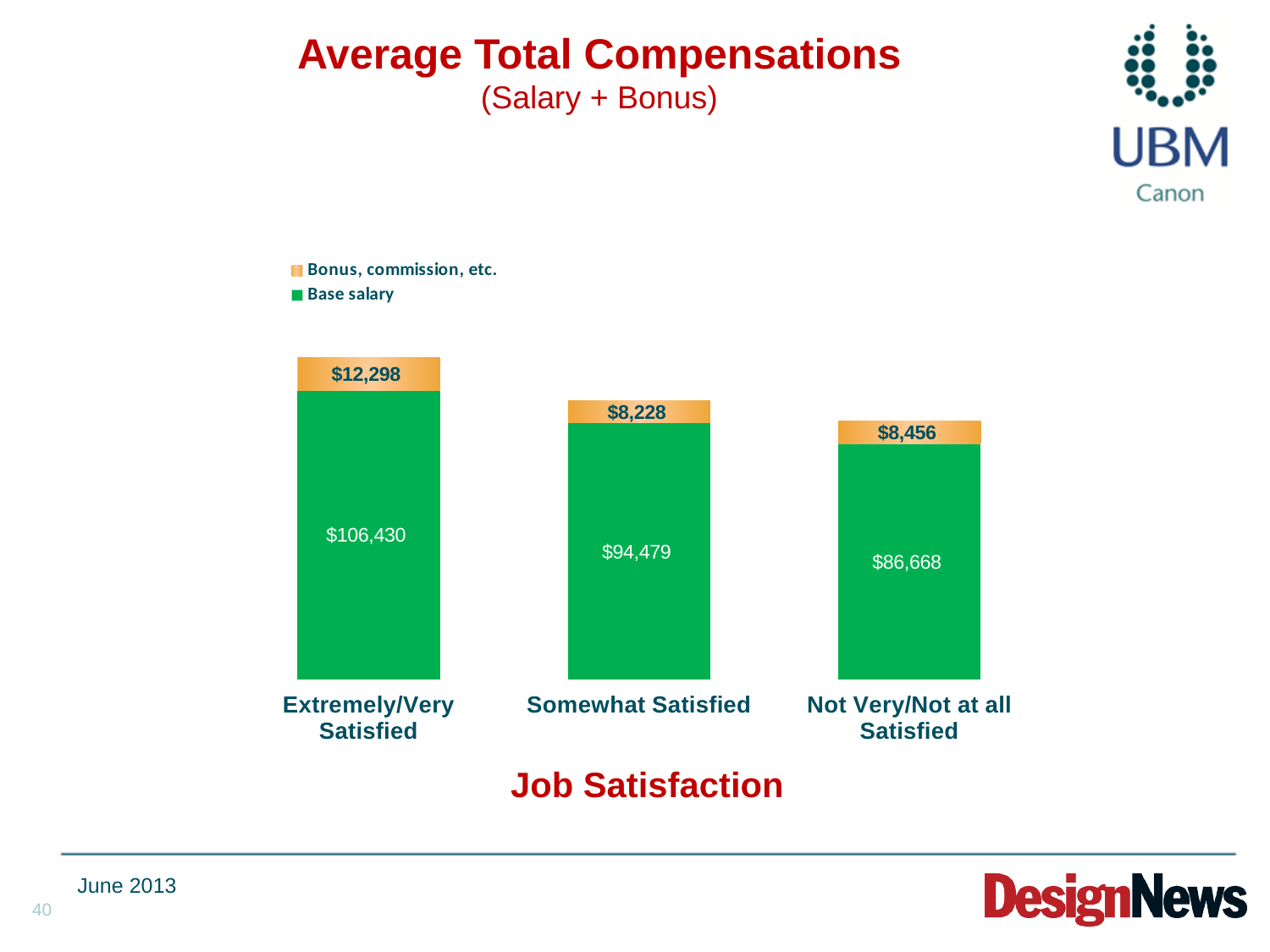
What is the total compensation (base salary plus bonus) for the Not Very/Not at all Satisfied group? $95,124 What is the bonus, commission, etc. value for the Not Very/Not at all Satisfied group? $8,456 What is the bonus, commission, etc. value for the Somewhat Satisfied group? $8,228 What is the total compensation (base salary plus bonus) for the Extremely/Very Satisfied group? $118,728 Which job satisfaction group has the highest base salary? Extremely/Very Satisfied What is the difference in base salary between the Extremely/Very Satisfied and Somewhat Satisfied groups? $11,951 How many series does the legend list? 2 Which job satisfaction group has the lowest bonus, commission, etc. value? Somewhat Satisfied How many job satisfaction categories are shown in the chart? 3 What is the base salary for the Not Very/Not at all Satisfied group? $86,668 What is the base salary for the Extremely/Very Satisfied group? $106,430 Which group has a larger bonus, commission, etc. value: Somewhat Satisfied or Not Very/Not at all Satisfied? Not Very/Not at all Satisfied